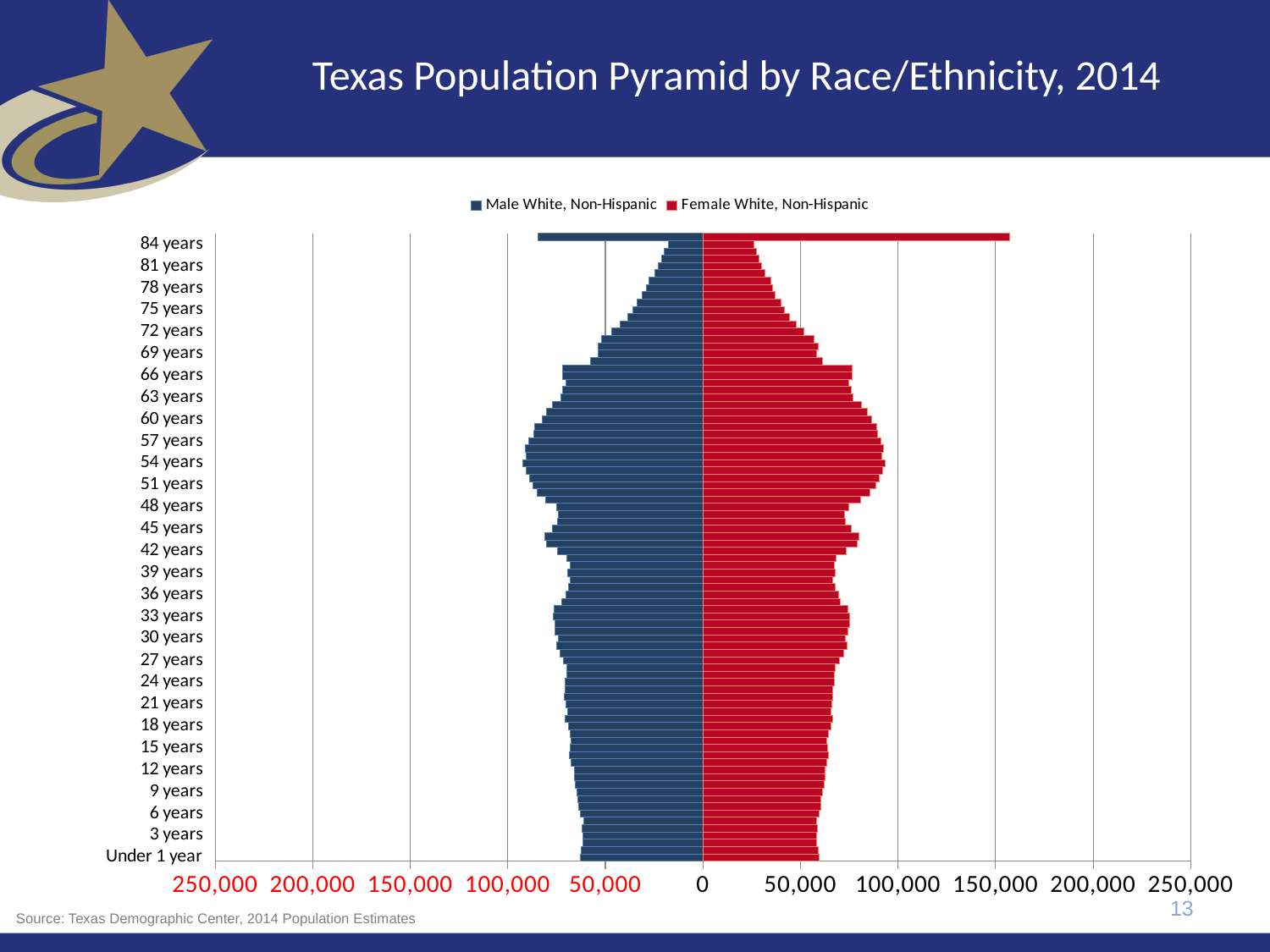
Is the Female White, Non-Hispanic value for Under 1 year greater or less than 50,000? greater Is the Male White, Non-Hispanic value for 75 years greater or less than 50,000? less Which series is shown in red? Female White, Non-Hispanic What is the title of the chart? Texas Population Pyramid by Race/Ethnicity, 2014 How many series does the legend list? 2 For 84 years, which is larger: the Male White, Non-Hispanic value or the Female White, Non-Hispanic value? Female White, Non-Hispanic What kind of chart is shown on the slide? Bar chart (population pyramid) For Female White, Non-Hispanic, which is larger: the value for 54 years or the value for 36 years? 54 years Is the Male White, Non-Hispanic value for 84 years greater or less than 100,000? less How many age labels are shown on the vertical axis? 29